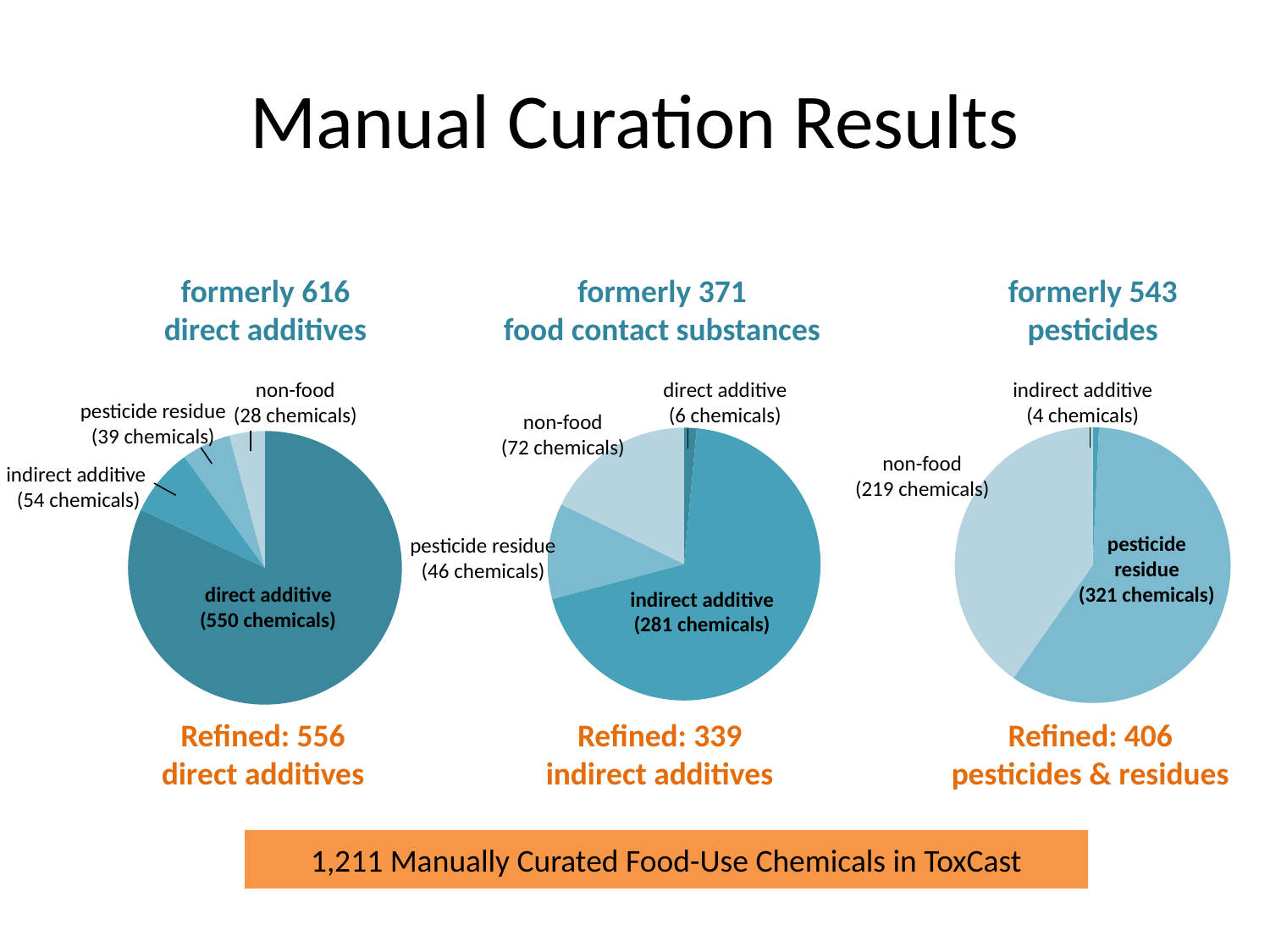
What type of chart is used for the three charts on the slide? Pie chart In the left pie chart (formerly 616 direct additives), which slice has more chemicals: indirect additive or pesticide residue? indirect additive In the right pie chart (formerly 543 pesticides), what is the difference in chemicals between the pesticide residue slice and the non-food slice? 102 In the right pie chart (formerly 543 pesticides), which slice is the smallest? indirect additive How many slices does the middle pie chart (formerly 371 food contact substances) have? 4 In the right pie chart (formerly 543 pesticides), how many chemicals are in the pesticide residue slice? 321 chemicals In the left pie chart (formerly 616 direct additives), how many chemicals are in the direct additive slice? 550 chemicals In the middle pie chart (formerly 371 food contact substances), which slice is the smallest? direct additive How many slices does the right pie chart (formerly 543 pesticides) have? 3 In the middle pie chart (formerly 371 food contact substances), how many chemicals are in the non-food slice? 72 chemicals In the left pie chart (formerly 616 direct additives), which slice is the largest? direct additive In the middle pie chart (formerly 371 food contact substances), what is the difference in chemicals between the indirect additive slice and the pesticide residue slice? 235